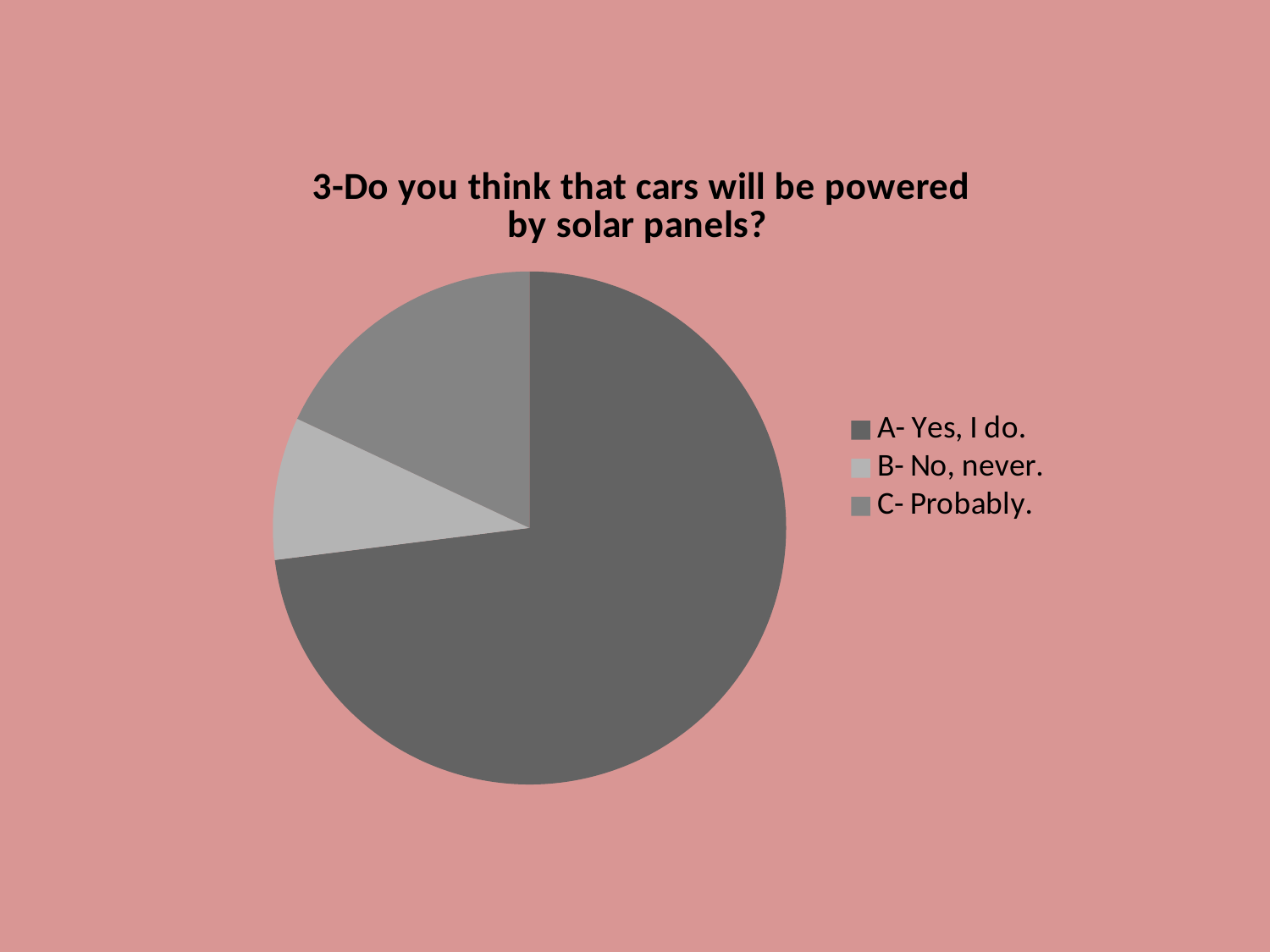
Does the slice for "A- Yes, I do." take up more or less than half of the pie? more How many slices does the pie chart have? 3 Which legend entry is listed first? A- Yes, I do. Which slice is larger: "B- No, never." or "C- Probably."? C- Probably. Which slice is larger: "A- Yes, I do." or "C- Probably."? A- Yes, I do. What is the title of the chart? 3-Do you think that cars will be powered by solar panels? Which category has the smallest slice of the pie? B- No, never. Which category has the largest slice of the pie? A- Yes, I do. What kind of chart is shown on the slide? pie chart How many entries does the legend list? 3